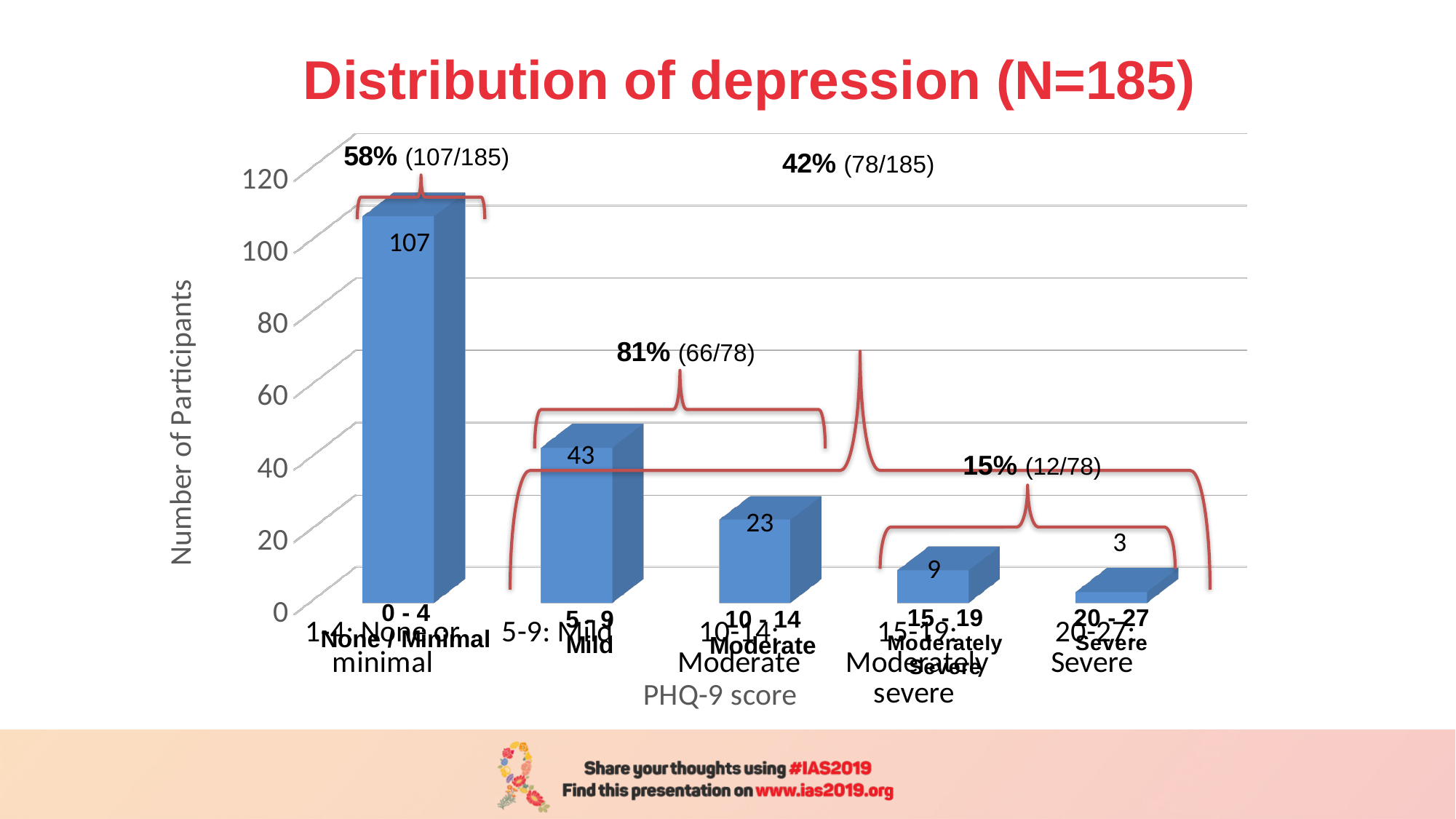
Do the values rise or fall as the PHQ-9 score categories increase along the x axis? Fall What is the label of the vertical axis of the chart? Number of Participants What is the difference in participants between the None / Minimal category and the Mild category? 64 What is the value shown for the Severe (20-27) category? 3 What is the number of participants in the Mild (5-9) category? 43 Which PHQ-9 score category has the lowest number of participants? 20 - 27 Severe How many PHQ-9 score categories are shown in the chart? 5 Which PHQ-9 score category has the highest number of participants? 0 - 4 None / Minimal What kind of chart is shown on the slide? Bar chart How many participants are in the Moderate (10-14) category? 23 Which category has more participants, Moderate or Moderately Severe? Moderate Is the value for the None / Minimal category greater or less than 100? greater